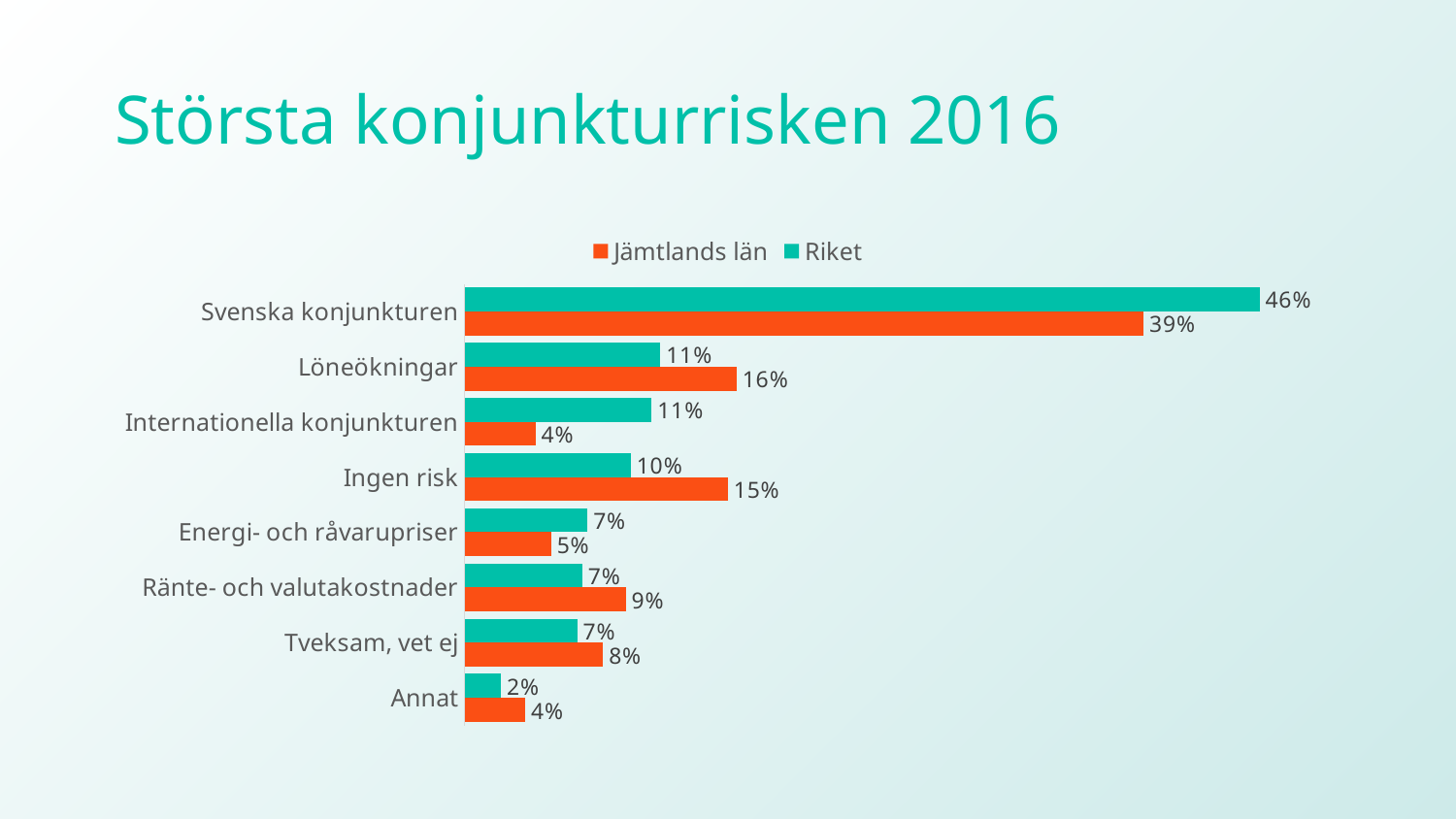
What kind of chart is shown on the slide? Bar chart Which category has the lowest value for Riket? Annat What is the value for Jämtlands län for Löneökningar? 16% Which is larger for Löneökningar, Jämtlands län or Riket? Jämtlands län How many categories are shown in the chart? 8 What is the difference between Jämtlands län and Riket for Ingen risk? 5% What is the value for Riket for Ingen risk? 10% How many series does the legend list? 2 Which category has the highest value for Jämtlands län? Svenska konjunkturen What is the value for Riket for Svenska konjunkturen? 46% What is the difference between Riket and Jämtlands län for Svenska konjunkturen? 7% What is the value for Jämtlands län for Internationella konjunkturen? 4%